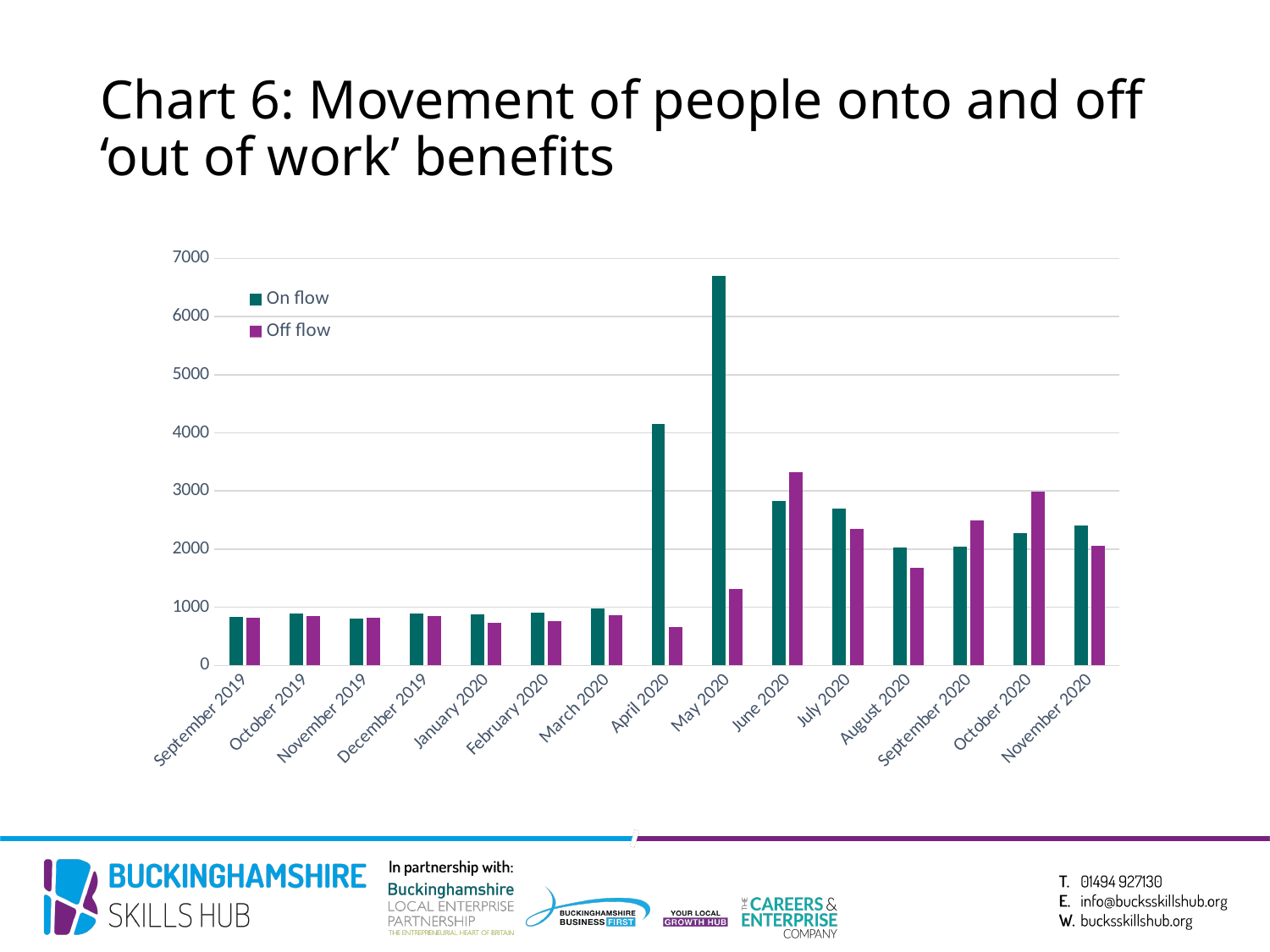
How many months are shown on the x axis? 15 What kind of chart is shown on the slide? bar chart Which month has the highest Off flow value? June 2020 How many series does the legend list? 2 In June 2020, which is larger, On flow or Off flow? Off flow Which month has the lowest Off flow value? April 2020 Is the On flow value for April 2020 greater or less than 4000? greater Is the Off flow value for April 2020 greater or less than 1000? less Which month has the highest On flow value? May 2020 Is the On flow value for May 2020 greater or less than 6000? greater What are the two series named in the legend? On flow and Off flow In April 2020, which is larger, On flow or Off flow? On flow